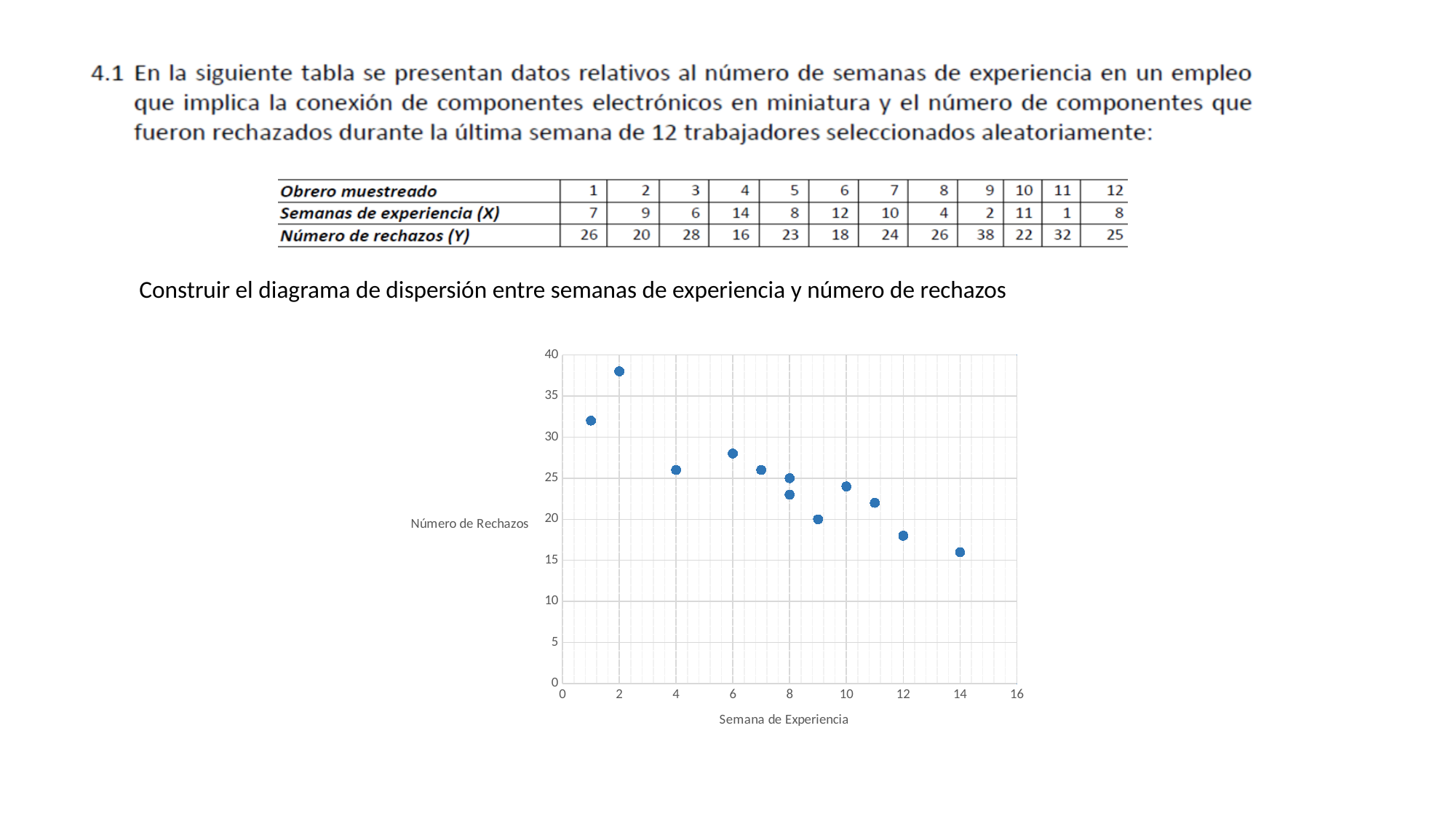
What is the number of rejections for the worker with 1 week of experience? 32 What is the difference between the highest and lowest number of rejections plotted? 22 How many data points are plotted in the scatter chart? 12 What is the title of the horizontal axis of the chart? Semana de Experiencia Is the number of rejections at 6 weeks of experience greater or less than 25? greater Do the number of rejections generally rise or fall as weeks of experience increase? Fall What is the number of rejections for the worker with 14 weeks of experience? 16 At which number of weeks of experience is the number of rejections lowest? 14 What kind of chart is shown on the slide? Scatter chart What is the title of the vertical axis of the chart? Número de Rechazos At which number of weeks of experience is the number of rejections highest? 2 What is the highest number of rejections plotted in the chart? 38